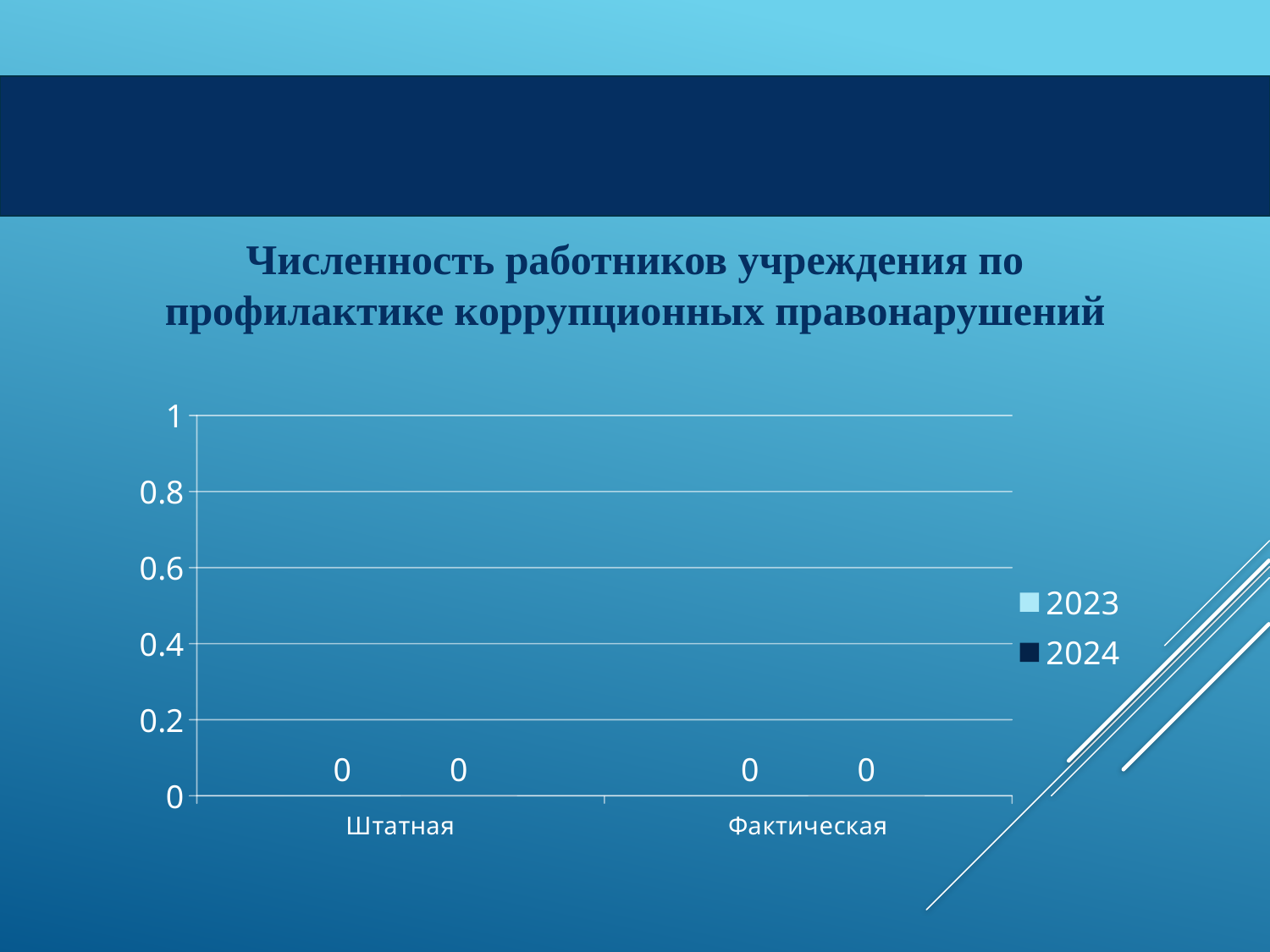
What is the value for Штатная in the 2023 series? 0 What kind of chart is shown on the slide? bar chart What is the value for Фактическая in the 2023 series? 0 What are the two series listed in the legend? 2023 and 2024 How many series does the legend list? 2 What is the title of the chart? Численность работников учреждения по профилактике коррупционных правонарушений How many categories are shown on the x axis? 2 What is the value for Фактическая in the 2024 series? 0 What is the value for Штатная in the 2024 series? 0 What is the difference between the 2024 and 2023 values for Фактическая? 0 What is the difference between the 2023 values for Штатная and Фактическая? 0 Is the value for Штатная in 2024 greater or less than 0.2? less